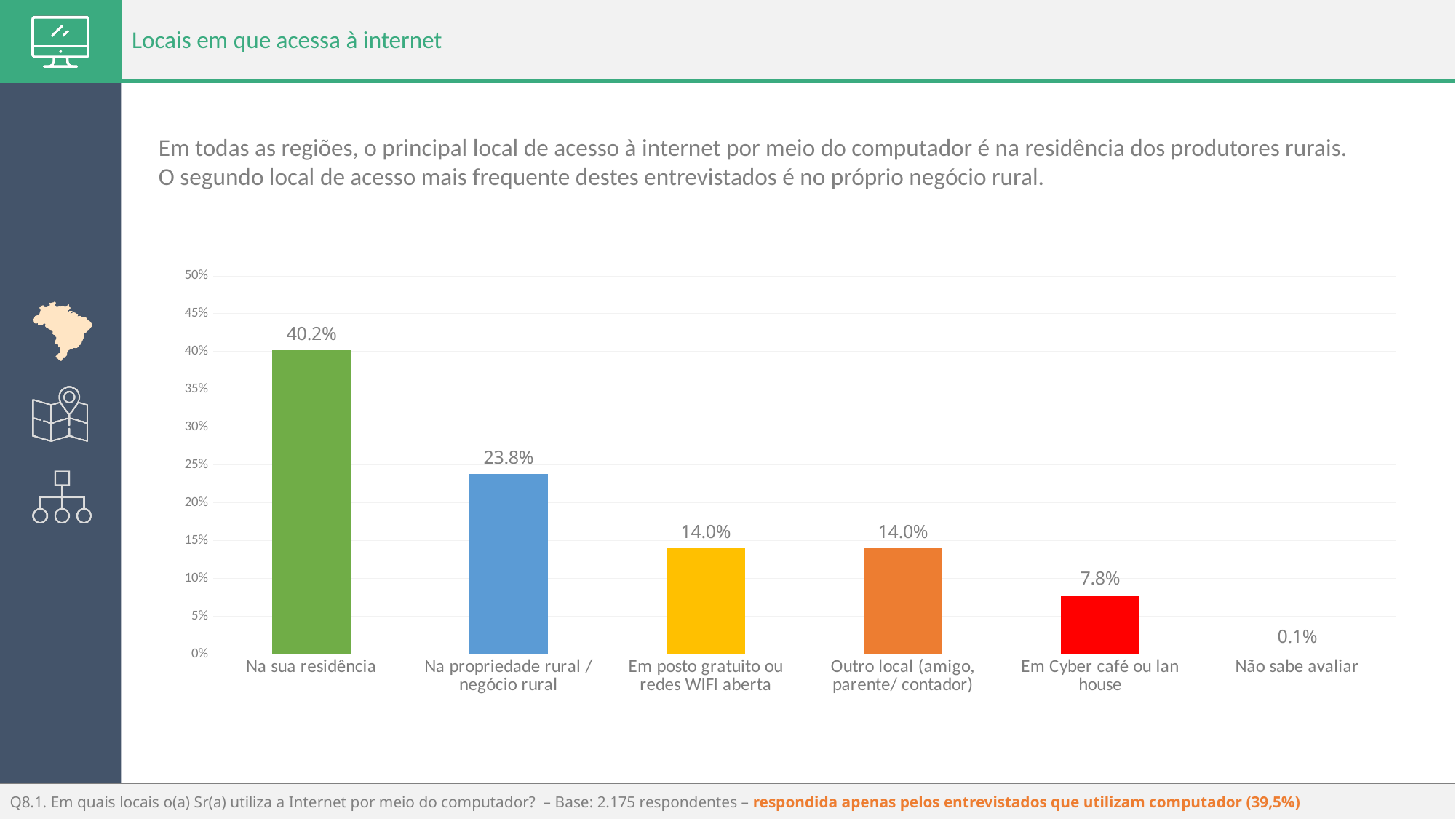
Which category has the lowest value? Não sabe avaliar How many categories are shown on the x axis? 6 What is the value for "Na propriedade rural / negócio rural"? 23.8% What kind of chart is shown on the slide? bar chart Which category has the highest value? Na sua residência Is the value for "Na propriedade rural / negócio rural" greater or less than 20%? greater What is the value for "Não sabe avaliar"? 0.1% What is the difference between "Na sua residência" and "Na propriedade rural / negócio rural"? 16.4% Which is larger: "Em posto gratuito ou redes WIFI aberta" or "Em Cyber café ou lan house"? Em posto gratuito ou redes WIFI aberta What is the value for "Em Cyber café ou lan house"? 7.8% What colour is the bar for "Outro local (amigo, parente/ contador)"? orange What is the value for "Na sua residência"? 40.2%